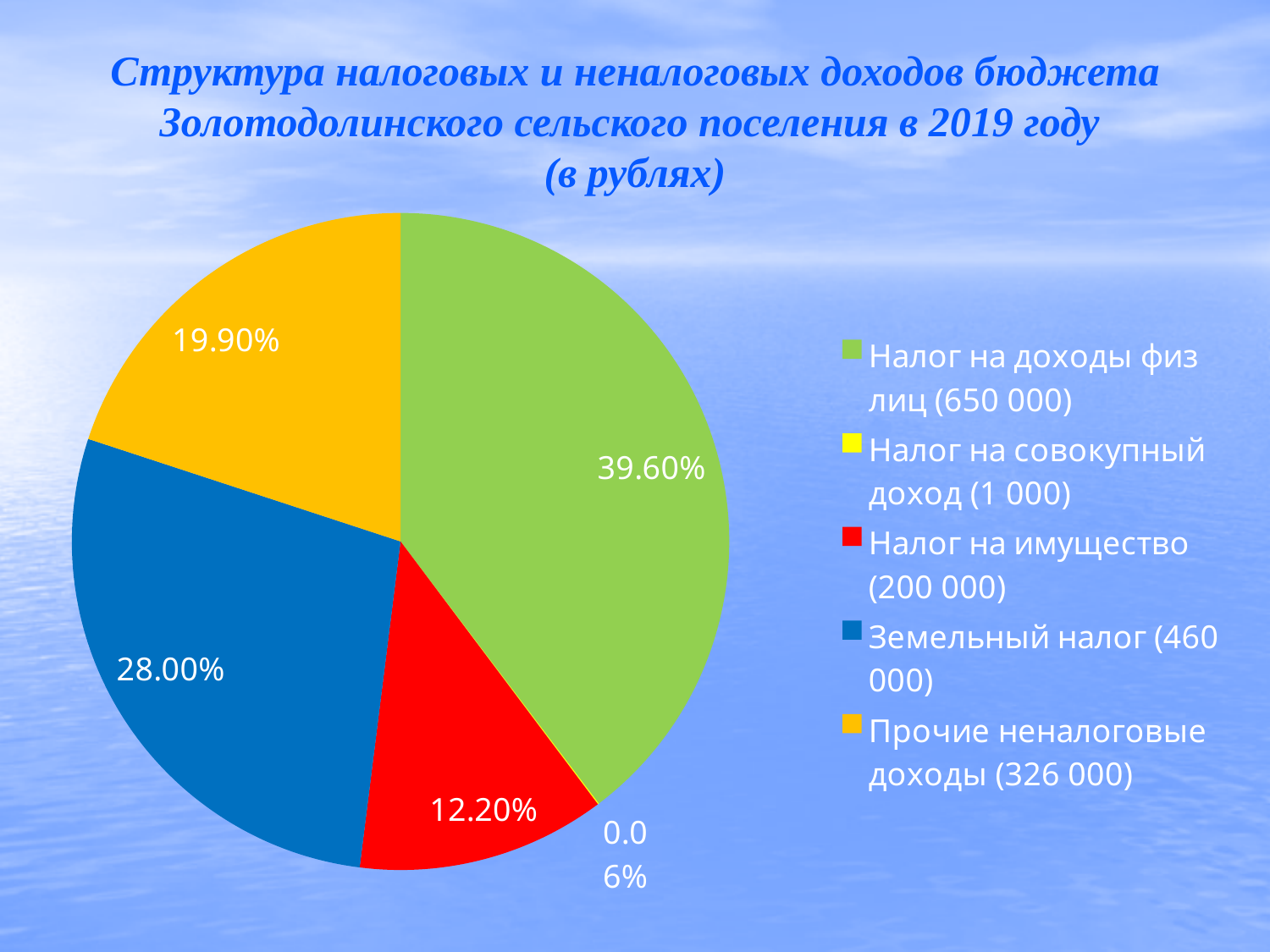
Which category has the smallest slice of the pie? Налог на совокупный доход What kind of chart is shown on the slide? pie chart How many categories does the legend list? 5 Which is larger: the share for "Земельный налог" or the share for "Прочие неналоговые доходы"? Земельный налог Which category has the largest slice of the pie? Налог на доходы физ лиц What share of the pie does "Налог на имущество" have? 12.20% What share of the pie does "Налог на доходы физ лиц" have? 39.60% What share of the pie does "Прочие неналоговые доходы" have? 19.90% What colour is the slice for "Налог на имущество"? red What is the difference in percentage points between the shares of "Налог на доходы физ лиц" and "Земельный налог"? 11.60% What amount in rubles is shown in the legend for "Земельный налог"? 460 000 What share of the pie does "Земельный налог" have? 28.00%